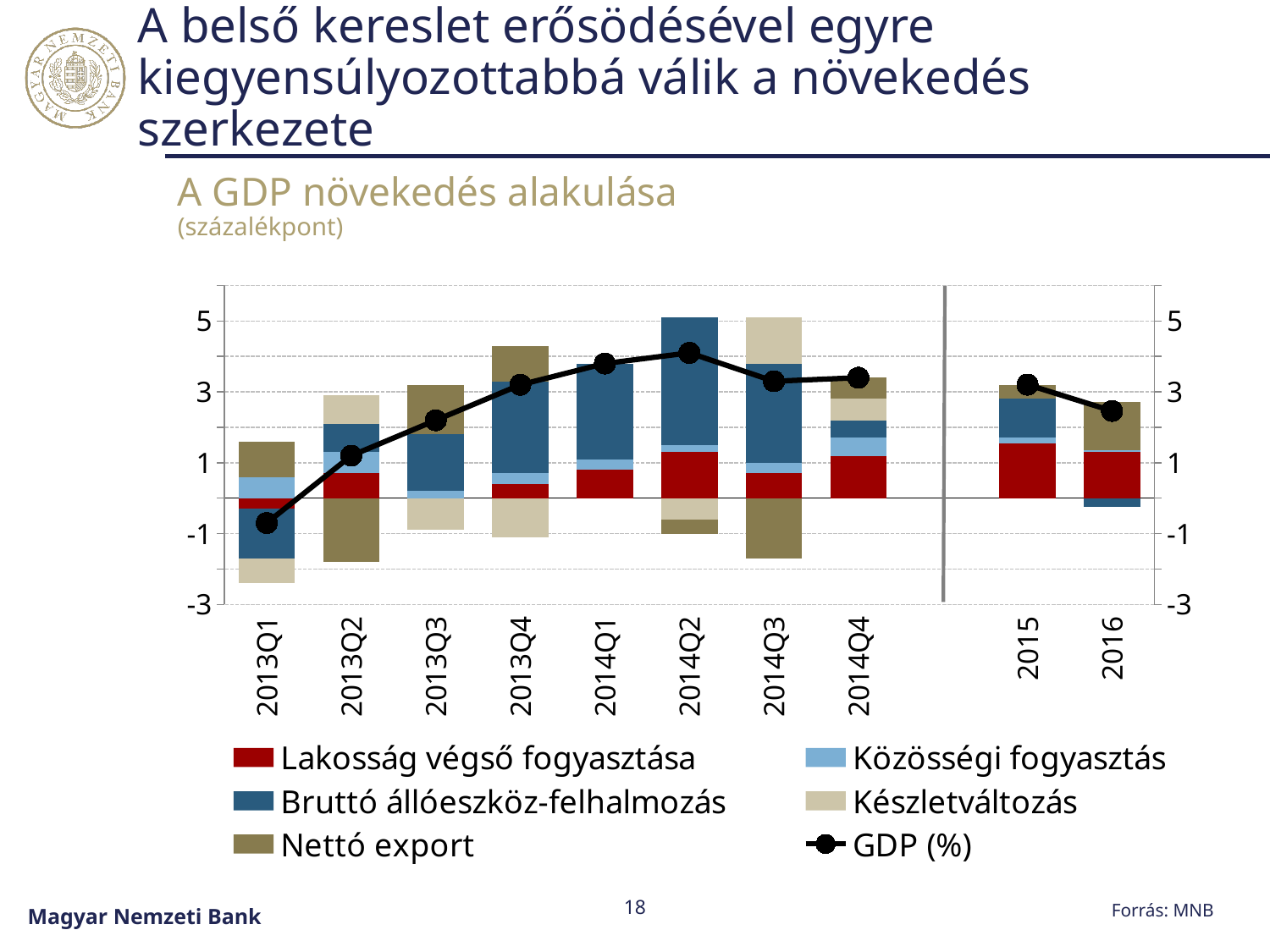
Is the GDP (%) value for 2016 greater or less than 3? less Is the GDP (%) value for 2014Q2 greater or less than 3? greater Which has the higher GDP (%) value, 2013Q3 or 2014Q1? 2014Q1 How many series does the chart's legend list? 6 In which period is the GDP (%) line at its lowest? 2013Q1 Is the GDP (%) value for 2013Q1 greater or less than 1? less What kind of chart is shown on the slide? A stacked bar chart with a line What is the title of the chart? A GDP növekedés alakulása In which period is the GDP (%) line at its highest? 2014Q2 Does the GDP (%) line rise or fall from 2013Q1 to 2014Q2? It rises How many categories are shown on the x axis of the chart? 10